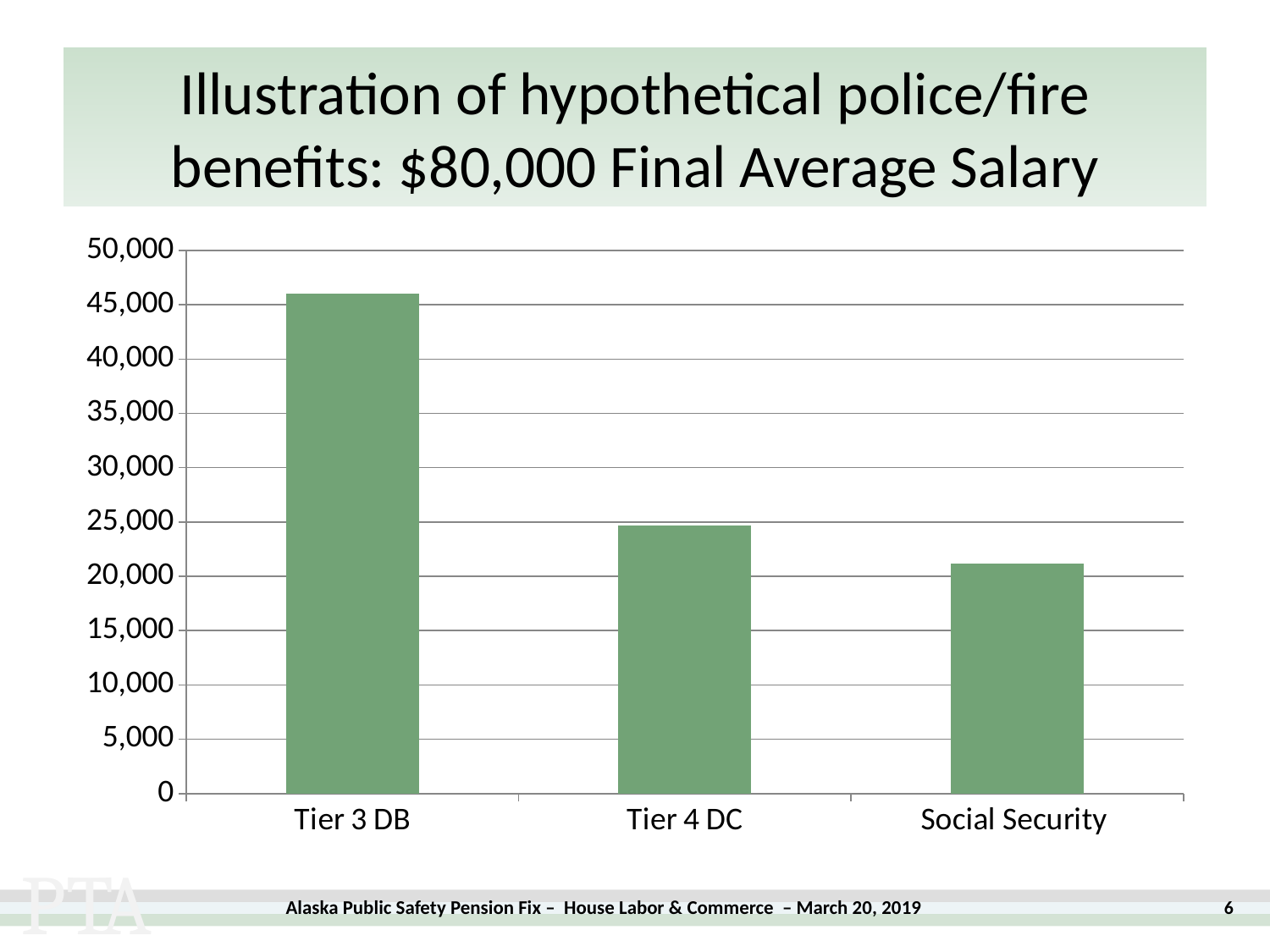
How many categories are shown on the x axis of the chart? 3 Is the value for Tier 4 DC greater or less than 30,000? less What type of chart is shown on the slide? bar chart Which category has the highest value in the chart? Tier 3 DB Is the value for Social Security greater or less than 20,000? greater Do the values rise or fall moving from left to right across the categories? fall Which is larger, the value for Tier 4 DC or the value for Social Security? Tier 4 DC Is the value for Tier 3 DB greater or less than 40,000? greater What is the title of the slide containing the chart? Illustration of hypothetical police/fire benefits: $80,000 Final Average Salary Which category has the lowest value in the chart? Social Security Which is larger, the value for Tier 3 DB or the value for Tier 4 DC? Tier 3 DB